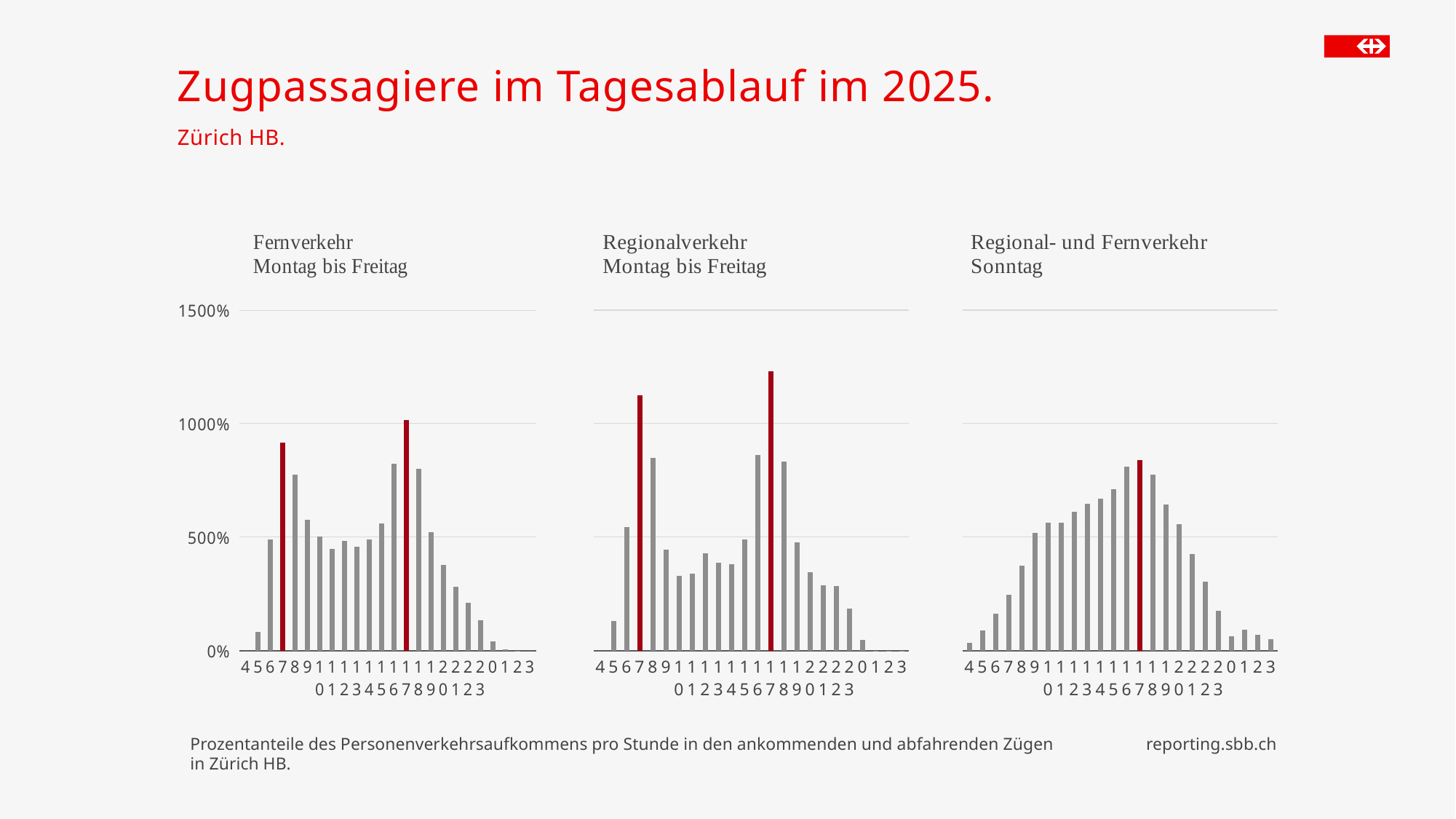
How many hourly categories does the Regionalverkehr Montag bis Freitag chart show on its x axis? 24 In the Regionalverkehr Montag bis Freitag chart, which hour has the highest value? 17 Which is larger: the value for hour 7 in the Regionalverkehr Montag bis Freitag chart or the value for hour 7 in the Fernverkehr Montag bis Freitag chart? Regionalverkehr Montag bis Freitag How many charts are shown on the slide? 3 In the Regional- und Fernverkehr Sonntag chart, which hour has the highest value? 17 In the Regionalverkehr Montag bis Freitag chart, is the value for hour 12 greater or less than 500%? less In the Fernverkehr Montag bis Freitag chart, is the value for hour 7 greater or less than 1000%? less In the Regional- und Fernverkehr Sonntag chart, is the value for hour 17 greater or less than 1000%? less In the Fernverkehr Montag bis Freitag chart, which hour has the highest value? 17 What kind of chart is the Fernverkehr Montag bis Freitag chart? bar chart What is the title of the slide? Zugpassagiere im Tagesablauf im 2025.